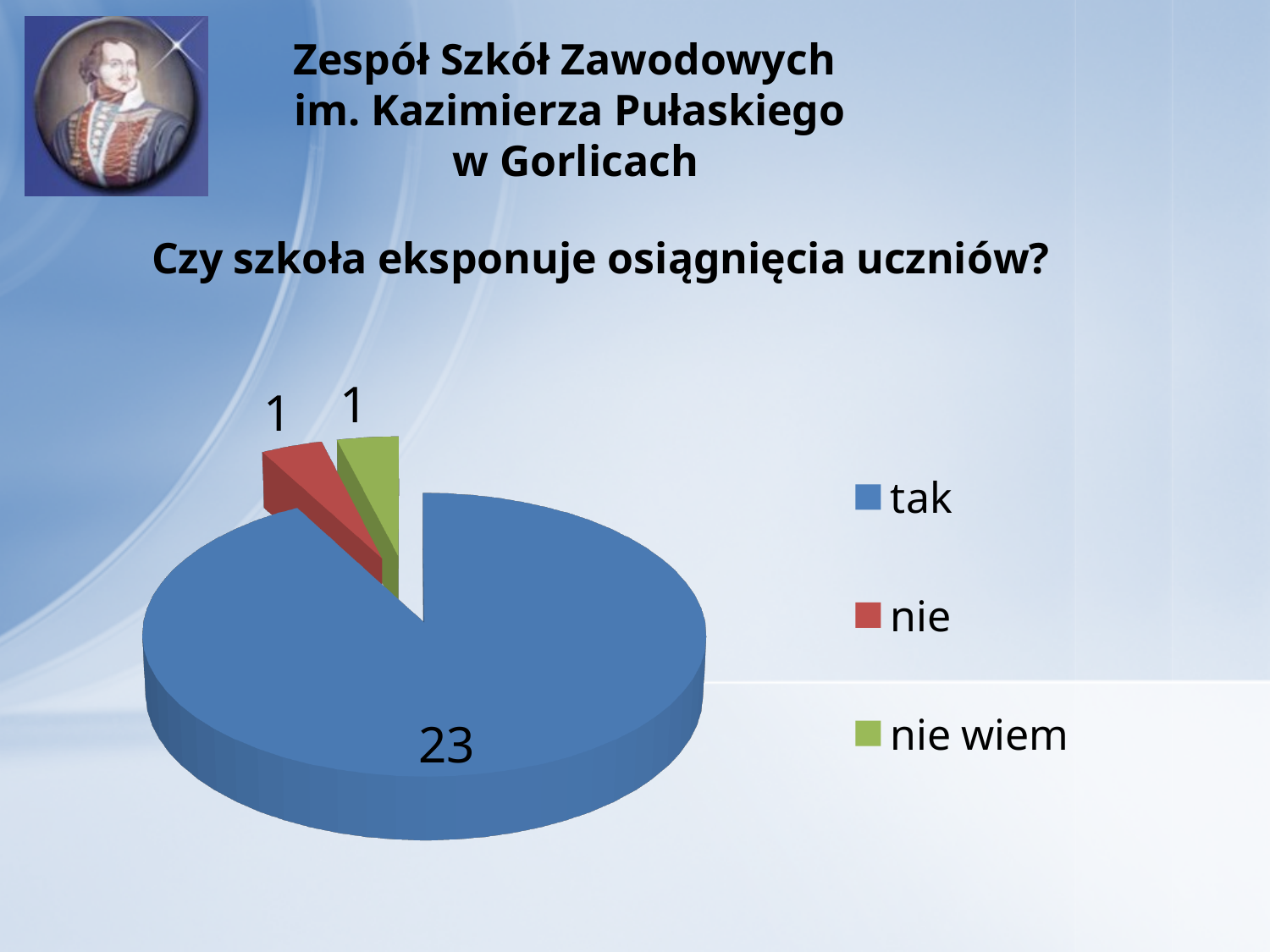
How many slices does the pie chart have? 3 What is the value for "nie"? 1 What share of the pie does "tak" represent? 92% Which category has the largest slice? tak What kind of chart is shown on the slide? pie chart What is the value for "tak"? 23 What is the total of all slices in the pie chart? 25 What is the value for "nie wiem"? 1 Which is larger, the value for "tak" or the value for "nie wiem"? tak How many entries does the legend list? 3 What is the difference between the values for "tak" and "nie"? 22 What colour is the "nie wiem" slice? green